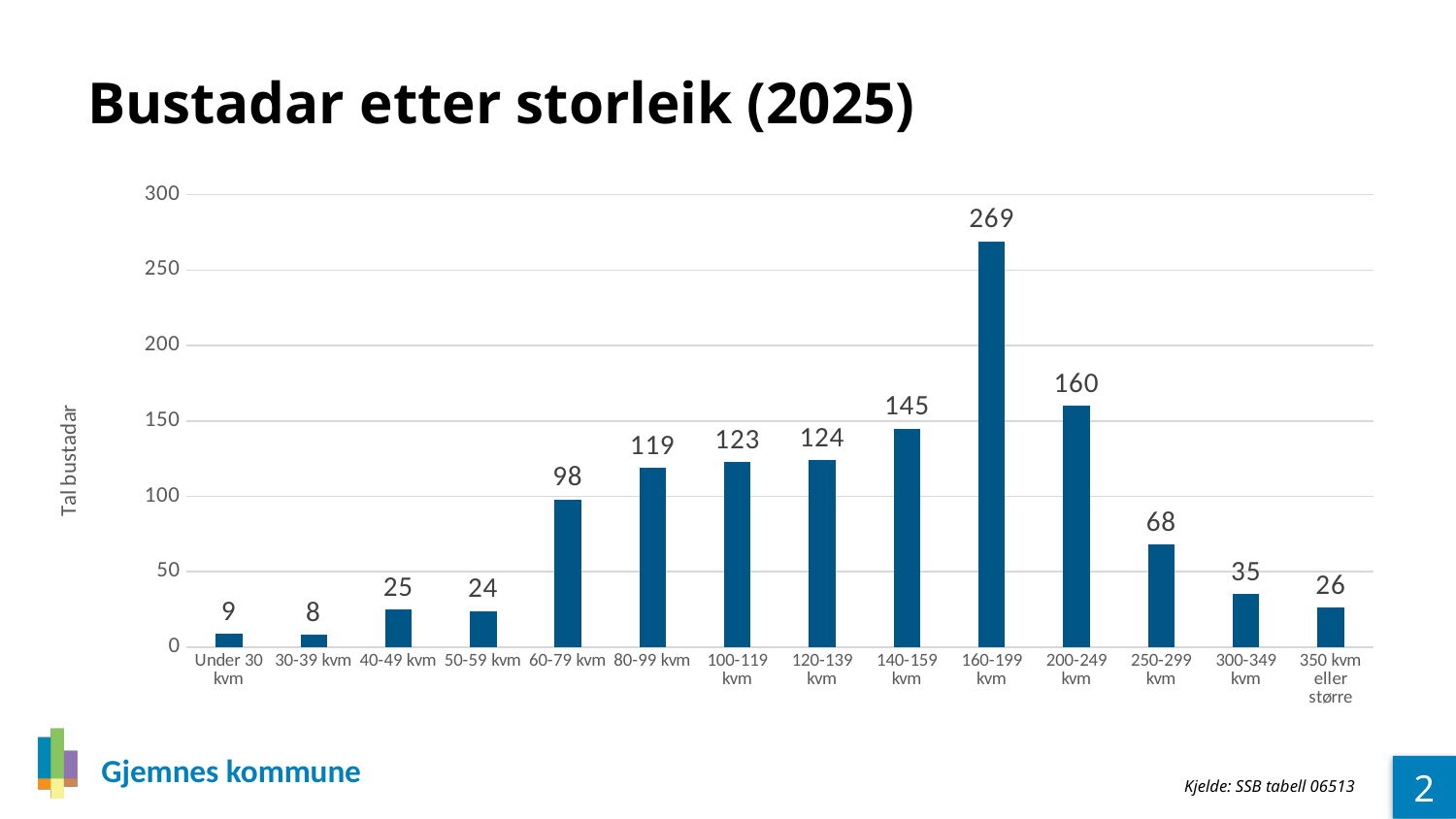
What is the difference between the values for 250-299 kvm and 300-349 kvm? 33 How many categories are shown on the x axis? 14 What is the value for the 350 kvm eller større category? 26 What is the difference between the values for 160-199 kvm and 200-249 kvm? 109 Is the value for 80-99 kvm greater or less than 100? greater How many dwellings are shown for the 60-79 kvm category? 98 Which category has the lowest value? 30-39 kvm Which is larger, the value for 140-159 kvm or the value for 200-249 kvm? 200-249 kvm What is the title of the chart? Bustadar etter storleik (2025) What kind of chart is shown on the slide? bar chart Which category has the highest value? 160-199 kvm What is the value for the 160-199 kvm category? 269